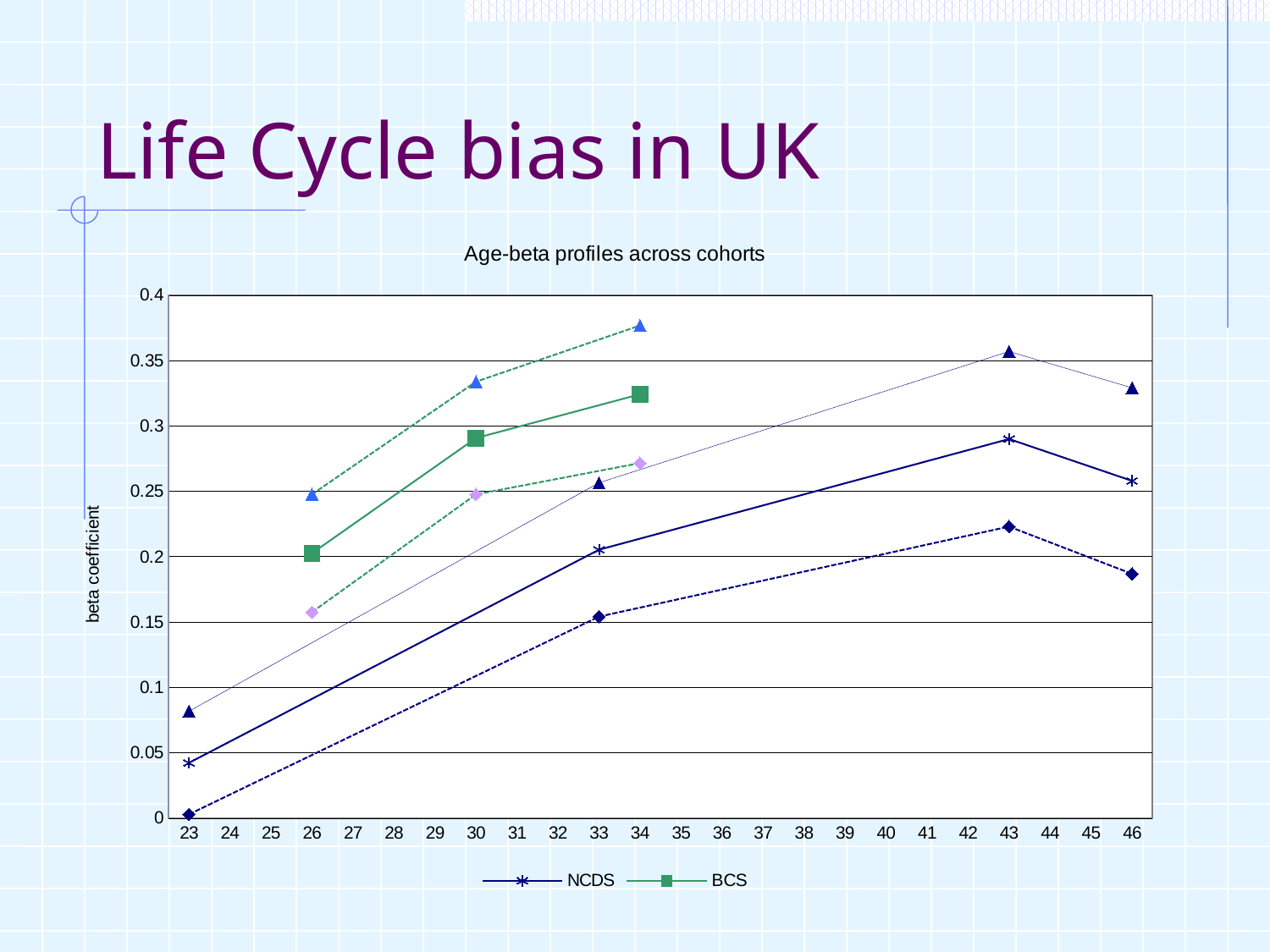
What is the label of the y axis? beta coefficient Is the BCS value at age 30 greater or less than 0.25? greater Is the BCS value at age 34 greater or less than 0.35? less How many series does the legend list? 2 Which is larger: the BCS value at age 30 or the NCDS value at age 33? BCS at age 30 Is the NCDS value at age 23 greater or less than 0.05? less What kind of chart is shown on the slide? line chart How many data points does the BCS series (square markers) have? 3 At which age does the NCDS series reach its highest value? 43 At which age does the BCS series have its lowest value? 26 How many data points does the NCDS series (star markers) have? 4 What is the title of the chart? Age-beta profiles across cohorts